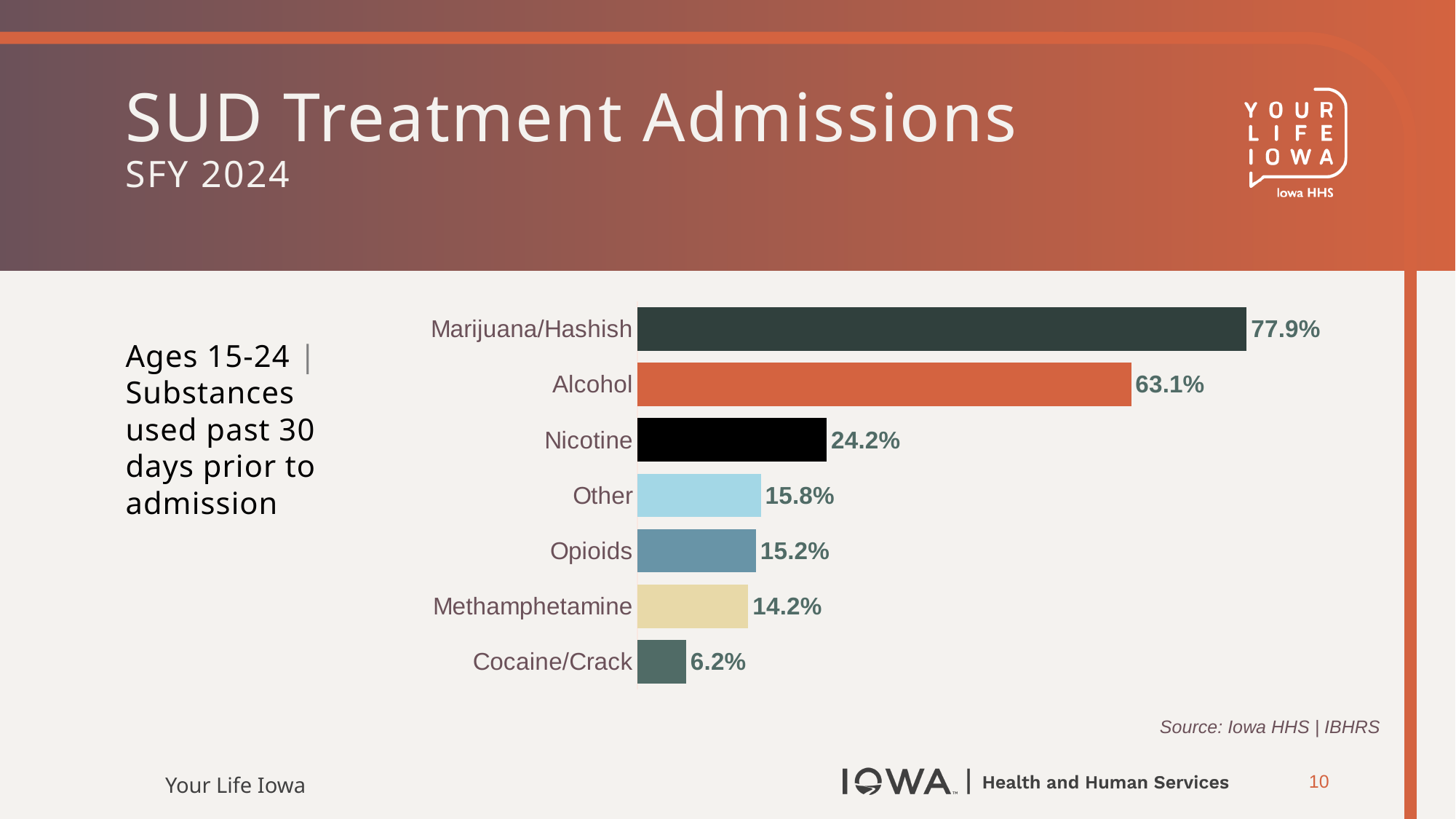
Which has a higher percentage, Nicotine or Other? Nicotine What percentage is shown for Methamphetamine? 14.2% What percentage is shown for Alcohol? 63.1% Which substance has the lowest percentage? Cocaine/Crack Which substance has the highest percentage? Marijuana/Hashish What is the difference in percentage points between Marijuana/Hashish and Alcohol? 14.8 What age group does the chart describe? Ages 15-24 What type of chart is shown on the slide? Bar chart What is the difference in percentage points between Nicotine and Opioids? 9.0 How many substance categories are shown in the chart? 7 What percentage is shown for Marijuana/Hashish? 77.9% What percentage is shown for Cocaine/Crack? 6.2%